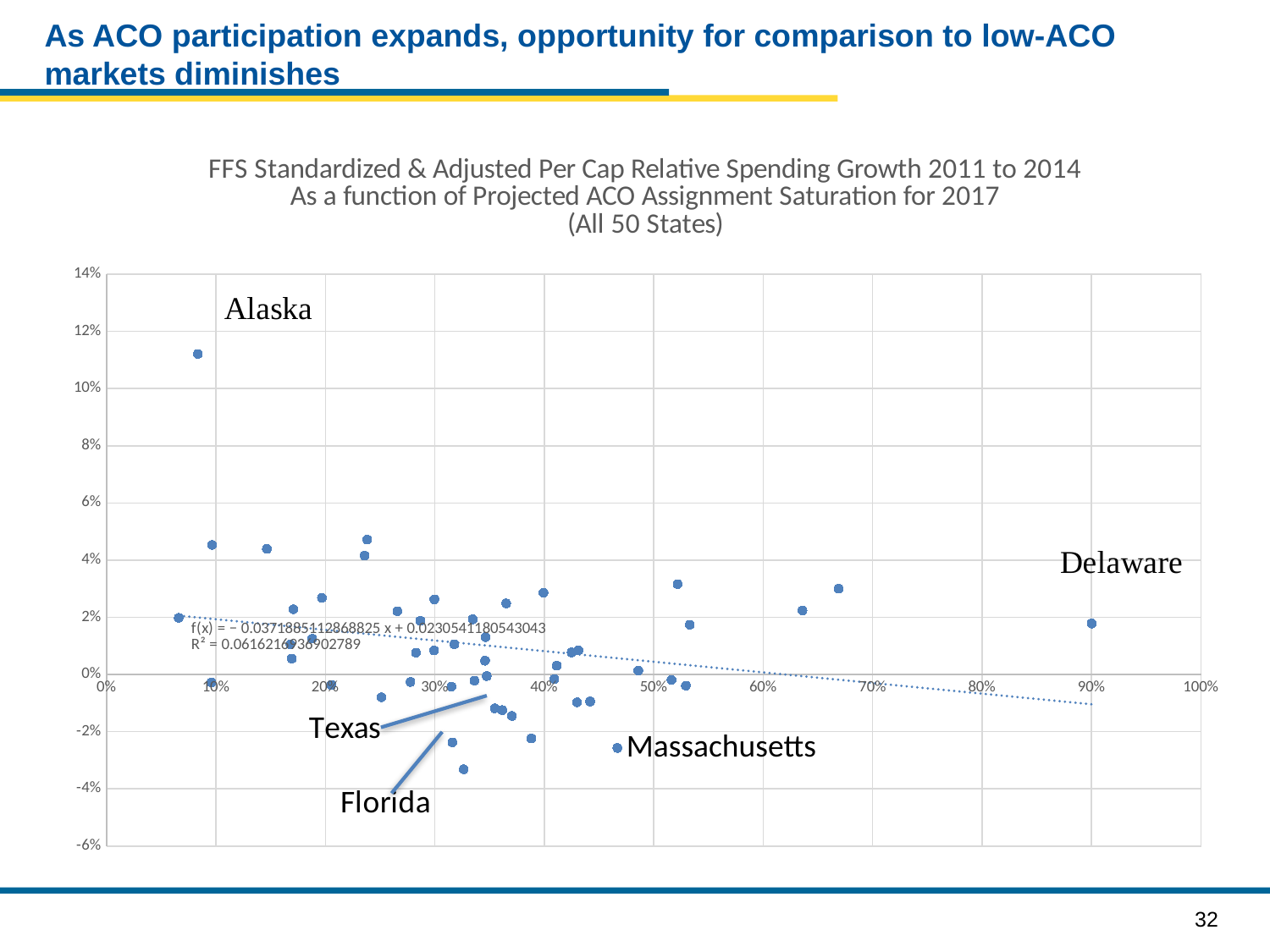
What is the first line of the chart's title? FFS Standardized & Adjusted Per Cap Relative Spending Growth 2011 to 2014 Is the projected ACO assignment saturation for Delaware greater or less than 80%? greater Which has the higher spending growth value, Alaska or Delaware? Alaska Is the spending growth value for Texas greater or less than 2%? less Is the spending growth value for Massachusetts greater or less than 0%? less Which labeled state has the highest per cap relative spending growth on the chart? Alaska Does the dotted trend line rise or fall as projected ACO assignment saturation increases? Falls Which labeled state has the highest projected ACO assignment saturation (furthest right on the x axis)? Delaware What kind of chart is shown on the slide? Scatter chart How many states are plotted on the chart, according to its subtitle? 50